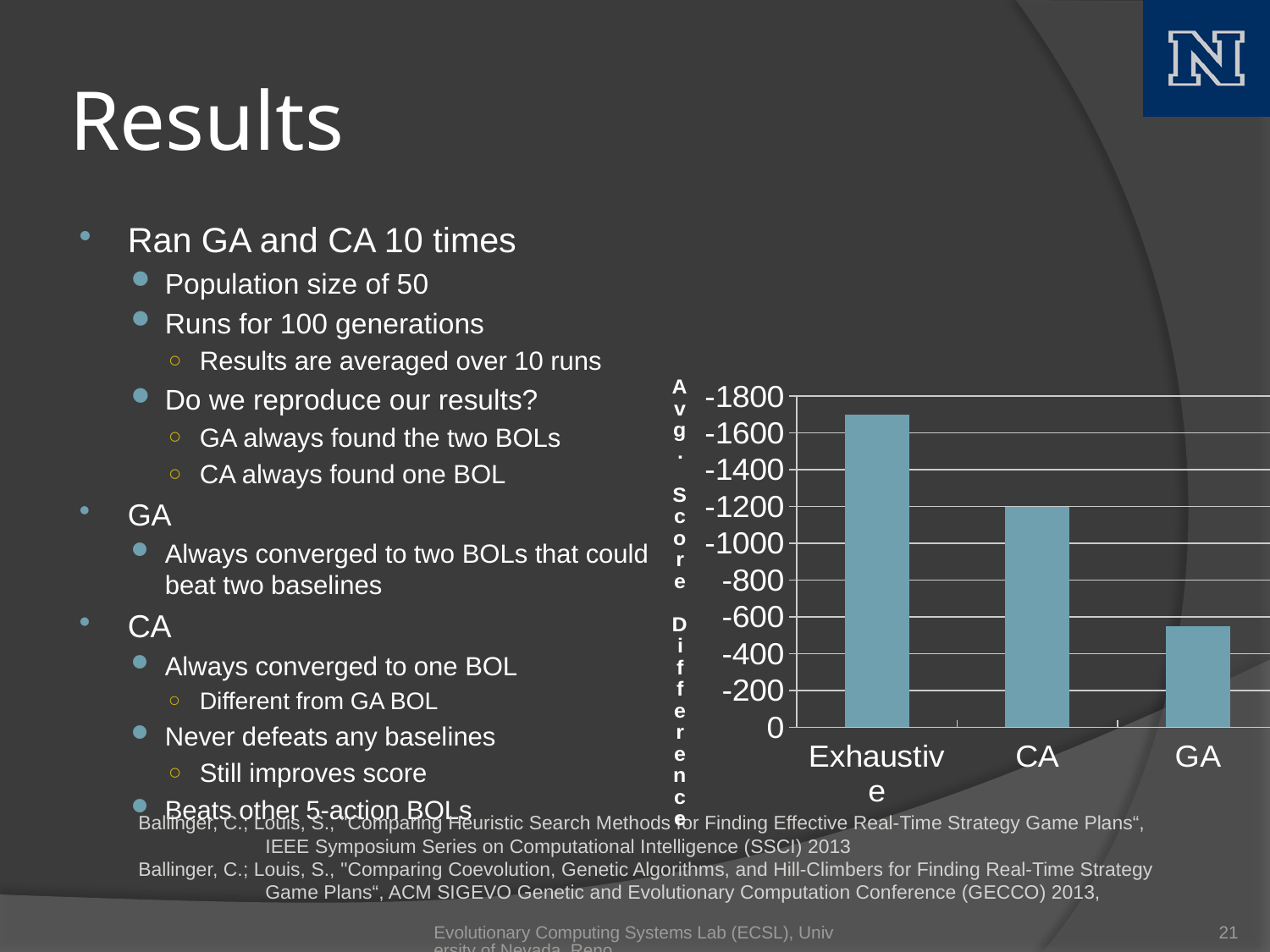
What is the Avg. Score Difference value for CA in the chart? -1200 Which bar is taller in the chart, Exhaustive or CA? Exhaustive What is the label on the vertical axis of the chart? Avg. Score Difference How many categories are plotted on the x axis of the chart? 3 What are the three category labels on the x axis of the chart? Exhaustive, CA, GA Which category has the tallest bar in the chart? Exhaustive Do the bar heights rise or fall moving from Exhaustive to GA along the x axis? fall Is the magnitude of the value for Exhaustive greater or less than 1600? greater What kind of chart is shown on the slide? bar chart Is the magnitude of the value for GA greater or less than 600? less Which category has the shortest bar in the chart? GA Which bar is taller in the chart, CA or GA? CA